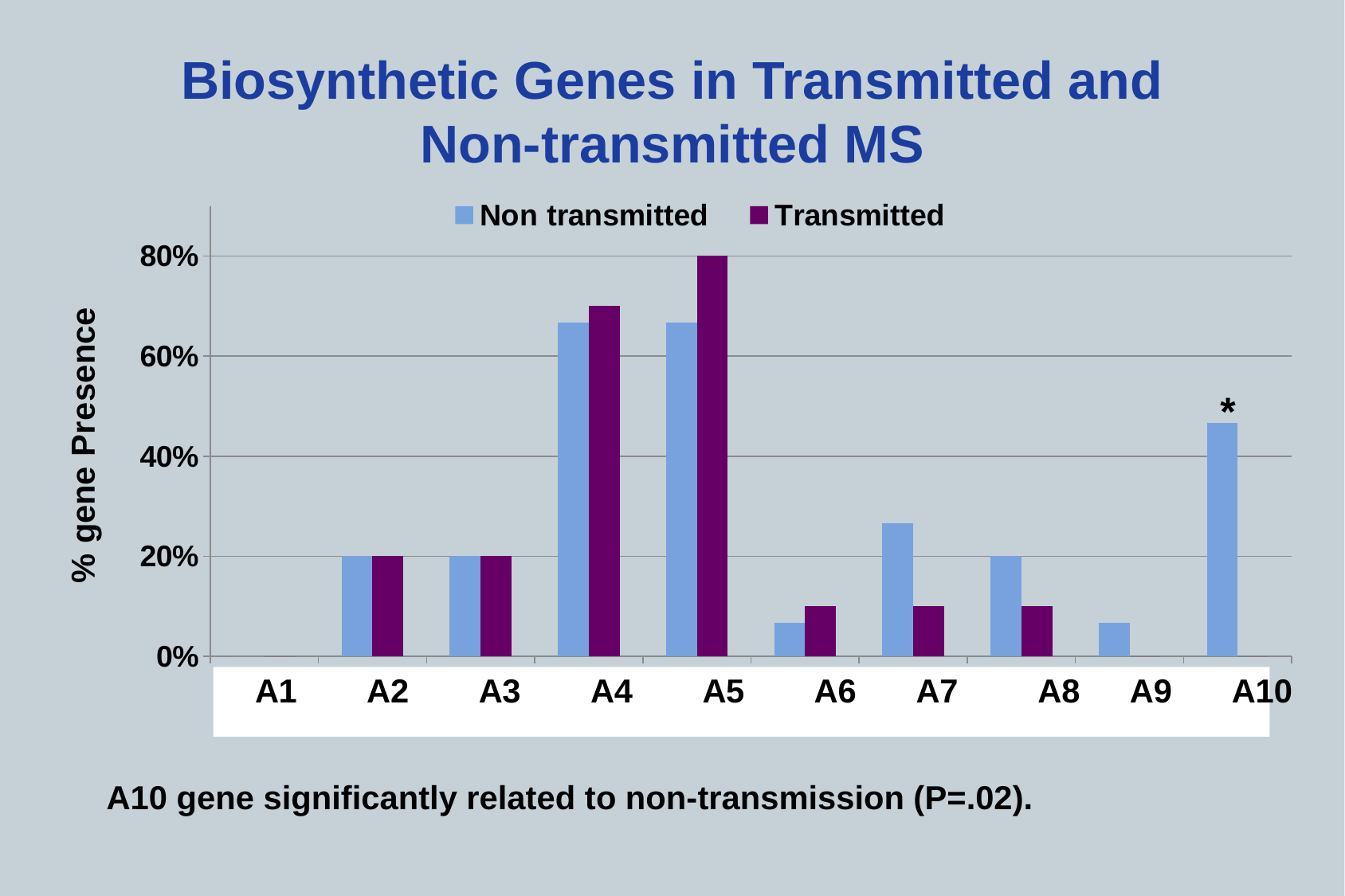
What is the Transmitted value for A5? 80% Is the Transmitted value for A6 greater or less than 20%? less For A7, which is larger: the Non transmitted value or the Transmitted value? Non transmitted How many series does the legend list? 2 Which category has the highest Transmitted value? A5 What is the Non transmitted value for A8? 20% How many gene categories are shown on the x axis? 10 Is the Non transmitted value for A10 greater or less than 40%? greater What is the Non transmitted value for A2? 20% What kind of chart is shown on the slide? bar chart What is the Transmitted value for A3? 20% What is the label on the y axis? % gene Presence